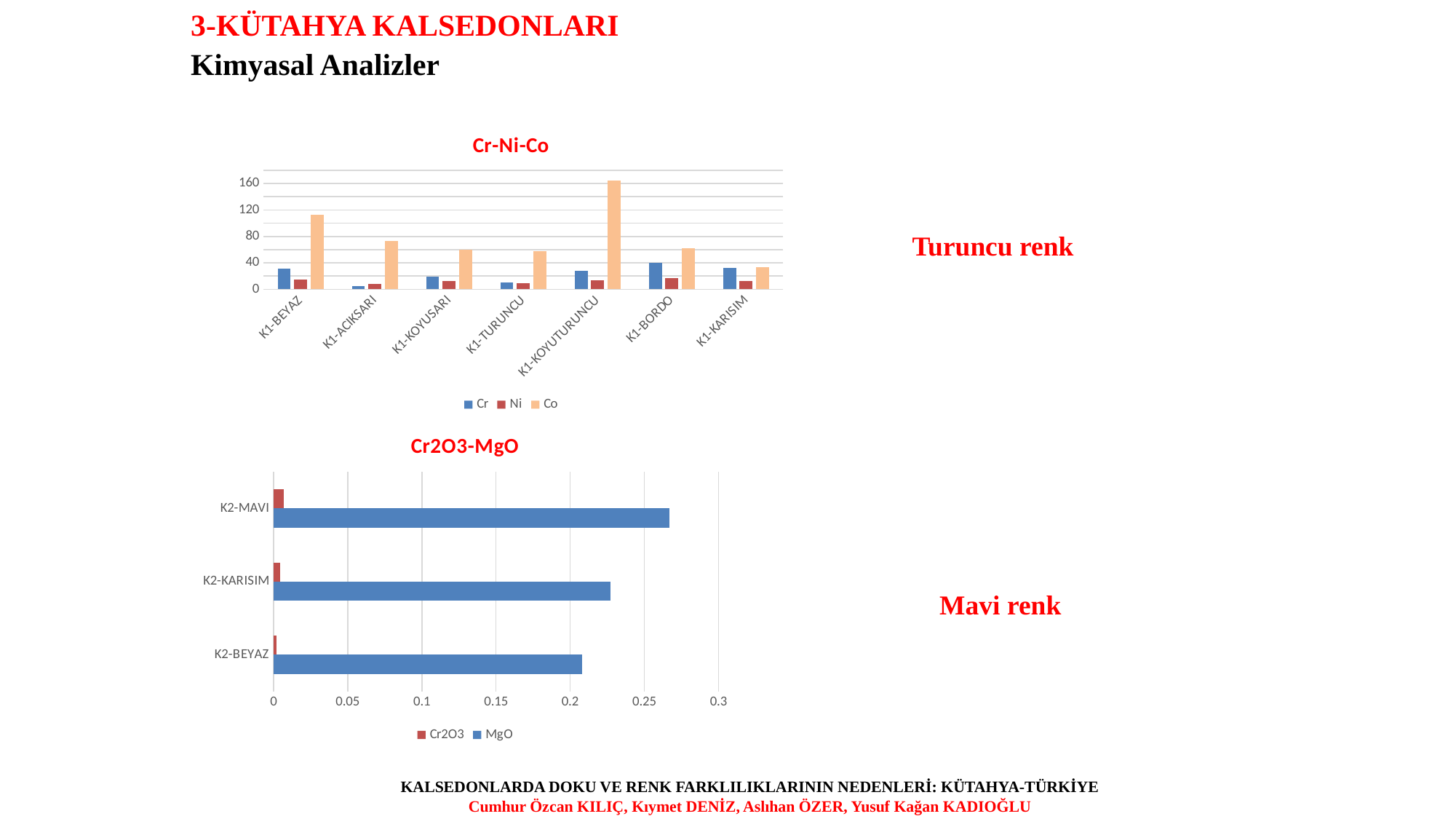
How many categories are shown on the x axis of the Cr-Ni-Co chart? 7 In the Cr-Ni-Co chart, which category has the highest Co value? K1-KOYUTURUNCU What type of chart is the Cr-Ni-Co chart? bar chart In the Cr-Ni-Co chart, which is larger for K1-BORDO, the Cr value or the Ni value? Cr How many series does the legend of the Cr-Ni-Co chart list? 3 In the Cr-Ni-Co chart, is the Co value for K1-KARISIM greater or less than 40? less In the Cr2O3-MgO chart, which category has the highest MgO value? K2-MAVI In the Cr-Ni-Co chart, is the Co value for K1-BEYAZ greater or less than 80? greater In the Cr2O3-MgO chart, is the MgO value for K2-KARISIM greater or less than 0.25? less How many categories are shown in the Cr2O3-MgO chart? 3 In the Cr-Ni-Co chart, which category has the lowest Cr value? K1-ACIKSARI What type of chart is the Cr2O3-MgO chart? bar chart